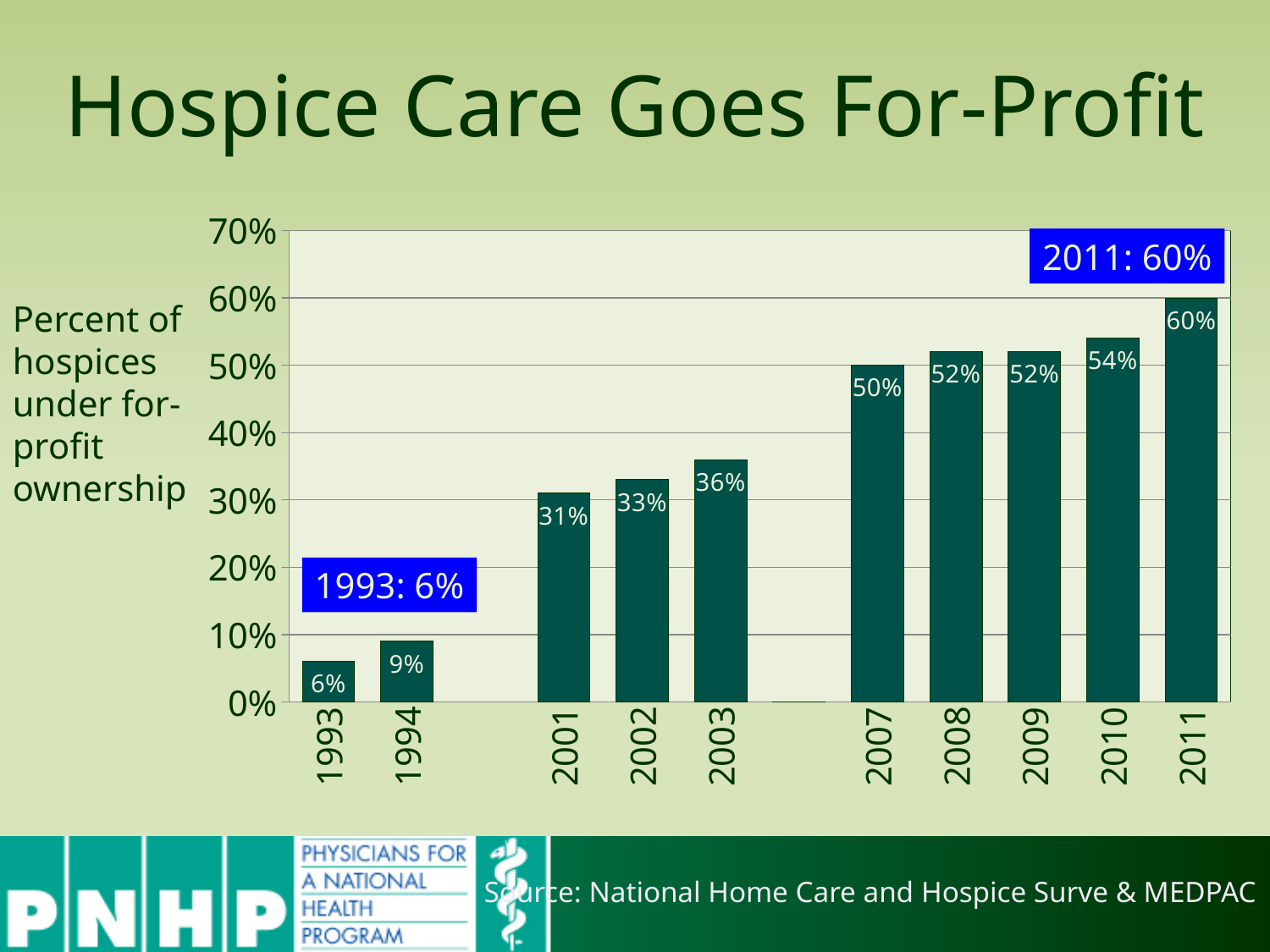
Do the values generally rise or fall from 1993 to 2011? Rise What is the value shown for 2010? 54% Which is larger, the value for 1994 or the value for 2001? 2001 What kind of chart is shown on the slide? Bar chart What is the difference between the values for 2003 and 2001? 5% What is the percent of hospices under for-profit ownership in 1993? 6% What is the value shown for 2003? 36% Is the value for 2007 greater or less than 40%? greater Which year has the lowest percent of hospices under for-profit ownership? 1993 What is the difference between the values for 2011 and 1993? 54% Which year has the highest percent of hospices under for-profit ownership? 2011 How many years have bars plotted on the chart? 10